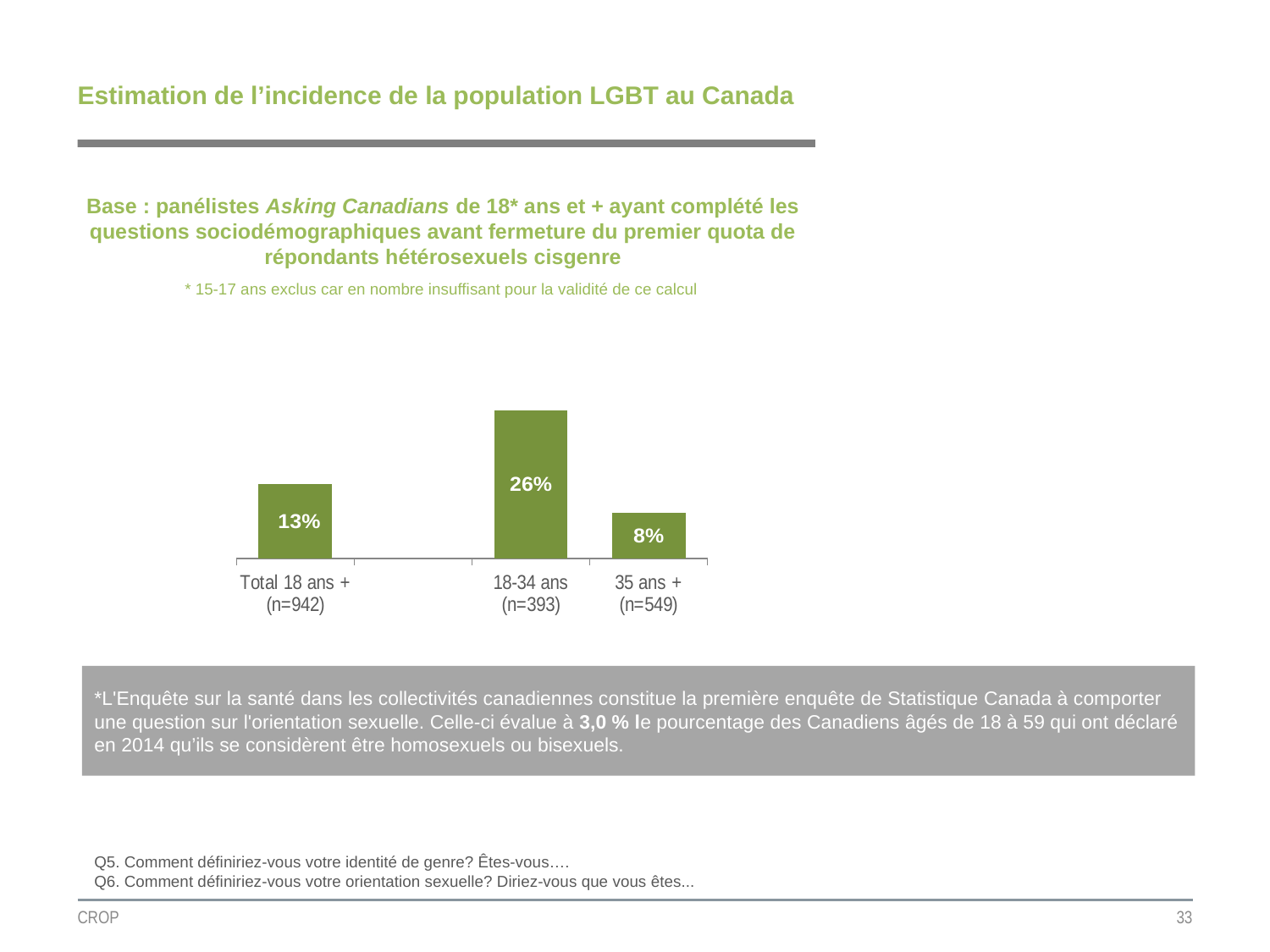
How many categories are shown in the chart? 3 Which is larger, the value for Total 18 ans + or the value for 35 ans +? Total 18 ans + What is the value for Total 18 ans + (n=942)? 13% What kind of chart is shown on the slide? Bar chart What is the value for 18-34 ans (n=393)? 26% What is the value for 35 ans + (n=549)? 8% Which category has the highest value? 18-34 ans What colour are the bars in the chart? Green What is the difference between the values for 18-34 ans and Total 18 ans +? 13% What is the difference between the values for 18-34 ans and 35 ans +? 18% What is the sample size (n) shown for the 18-34 ans category? n=393 Which category has the lowest value? 35 ans +